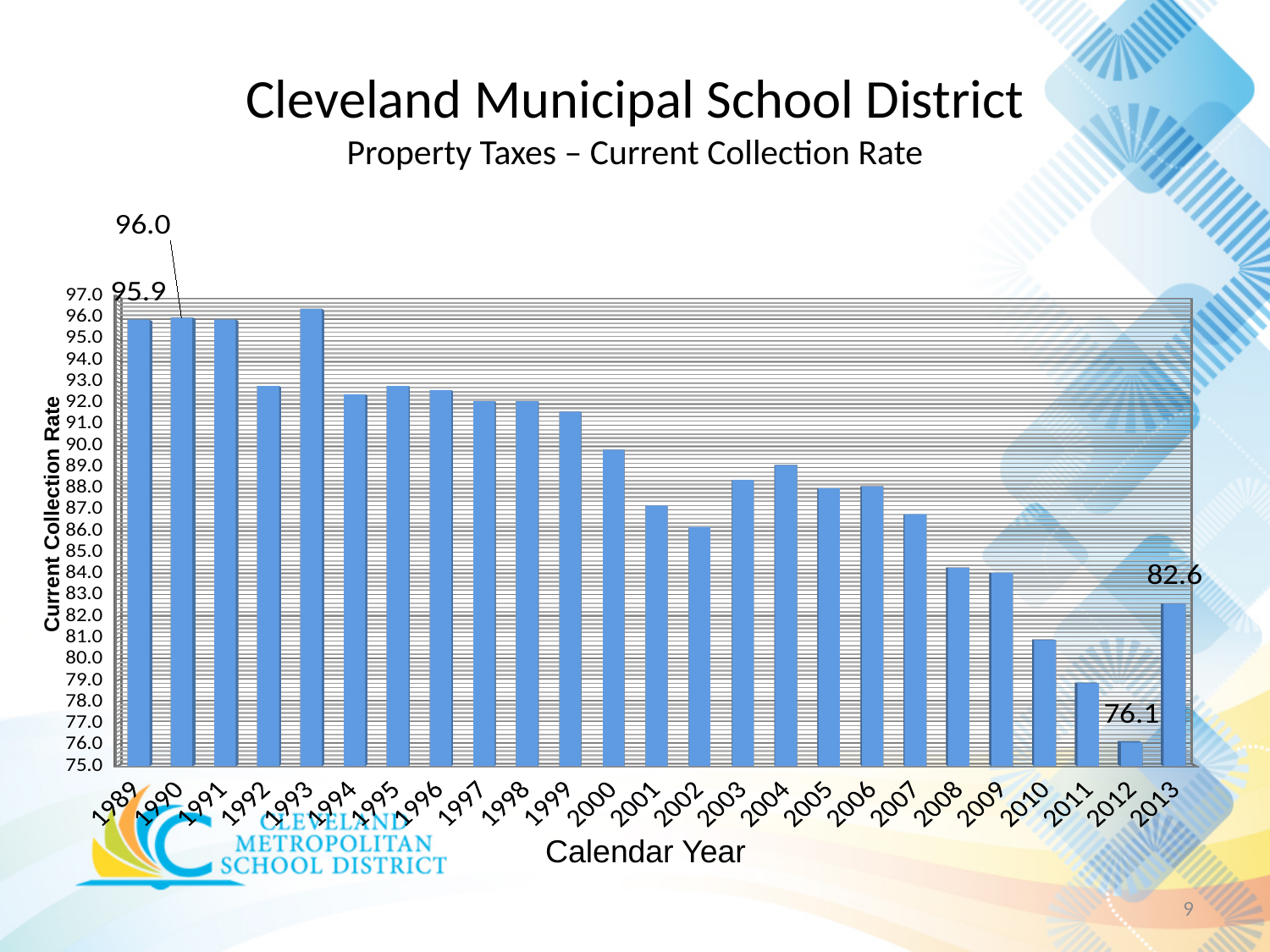
What is the difference between the collection rates for 1990 and 1989? 0.1 How many calendar years are shown on the x axis? 25 Is the value for 2004 greater or less than 88.0? greater Which year has the higher collection rate, 1989 or 2013? 1989 What kind of chart is shown on the slide? Bar chart What is the current collection rate for 2012? 76.1 By how much did the current collection rate increase from 2012 to 2013? 6.5 What is the current collection rate for 2013? 82.6 Is the value for 2008 greater or less than 85.0? less What is the current collection rate for 1989? 95.9 What is the current collection rate for 1990? 96.0 Which calendar year has the lowest current collection rate? 2012